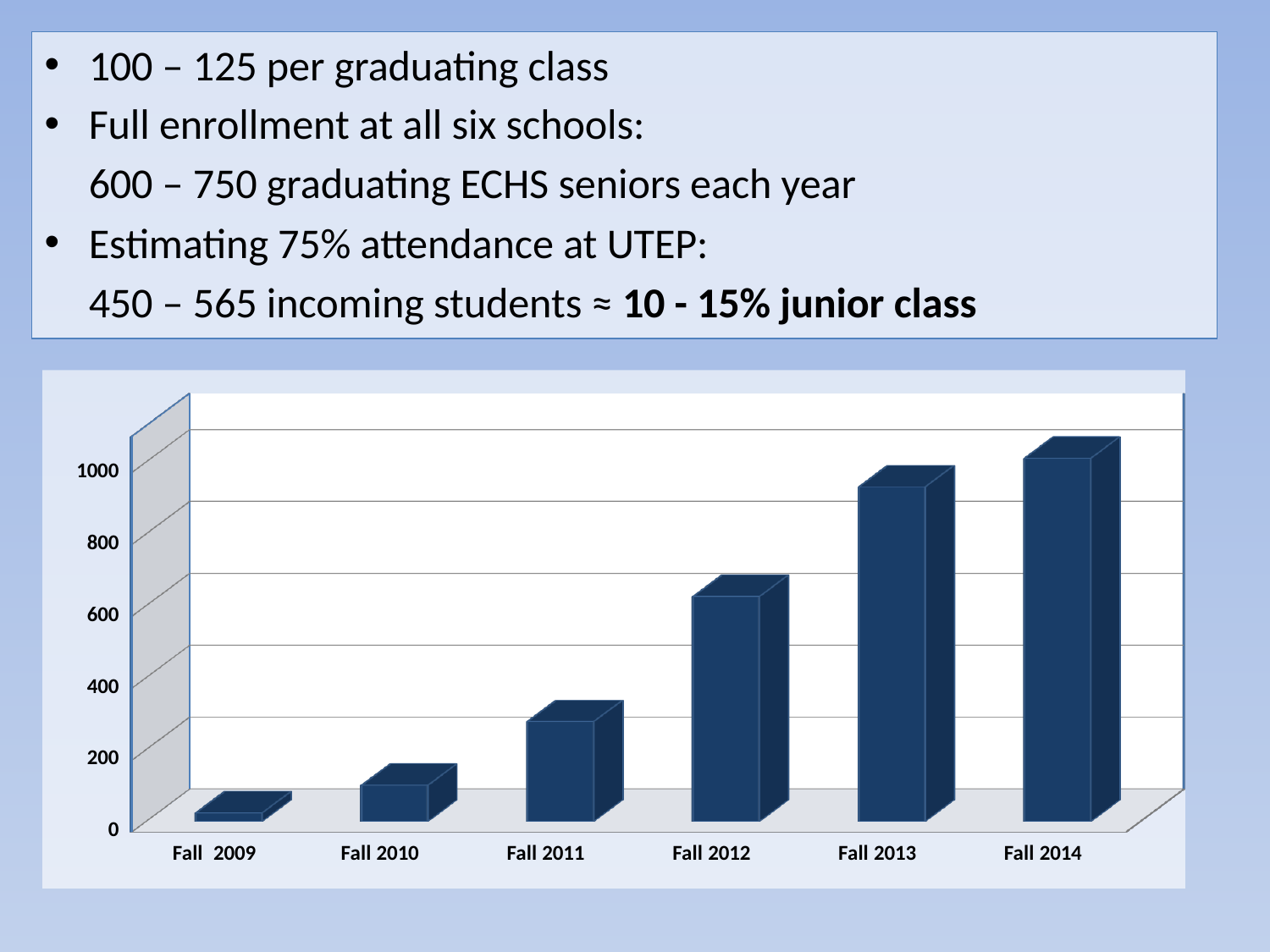
What kind of chart is shown on the slide? bar chart Is the value for Fall 2010 greater or less than 200? less Which is larger, the value for Fall 2012 or the value for Fall 2011? Fall 2012 Which category has the lowest bar in the chart? Fall 2009 Is the value for Fall 2011 greater or less than 200? greater Is the value for Fall 2013 greater or less than 800? greater Which category has the highest bar in the chart? Fall 2014 What is the first category label on the x axis of the chart? Fall 2009 How many categories are shown on the x axis of the chart? 6 Do the values rise or fall from Fall 2009 to Fall 2014? rise